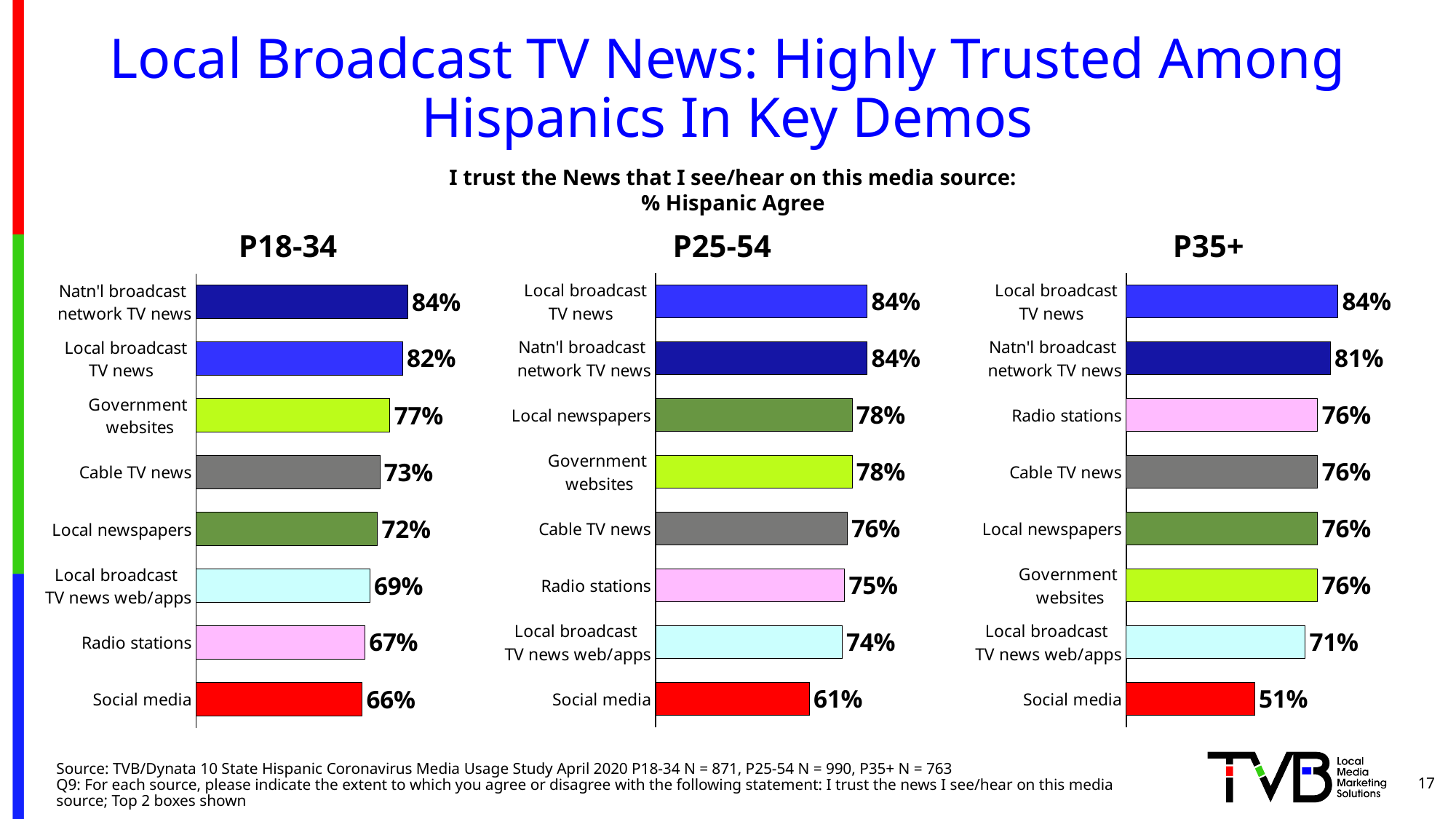
How many categories are shown in the P25-54 chart? 8 In the P35+ chart, what is the difference between Local broadcast TV news and Natn'l broadcast network TV news? 3% How many charts are shown on the slide? 3 In the P18-34 chart, what is the difference between Natn'l broadcast network TV news and Social media? 18% In the P18-34 chart, which is larger: Radio stations or Cable TV news? Cable TV news In the P25-54 chart, what is the value for Social media? 61% In the P18-34 chart, which category has the highest value? Natn'l broadcast network TV news In the P35+ chart, what is the value for Local broadcast TV news web/apps? 71% In the P25-54 chart, which is larger: Local newspapers or Cable TV news? Local newspapers What kind of chart is used for the P35+ data? Bar chart In the P18-34 chart, what is the value for Government websites? 77% In the P35+ chart, which category has the lowest value? Social media